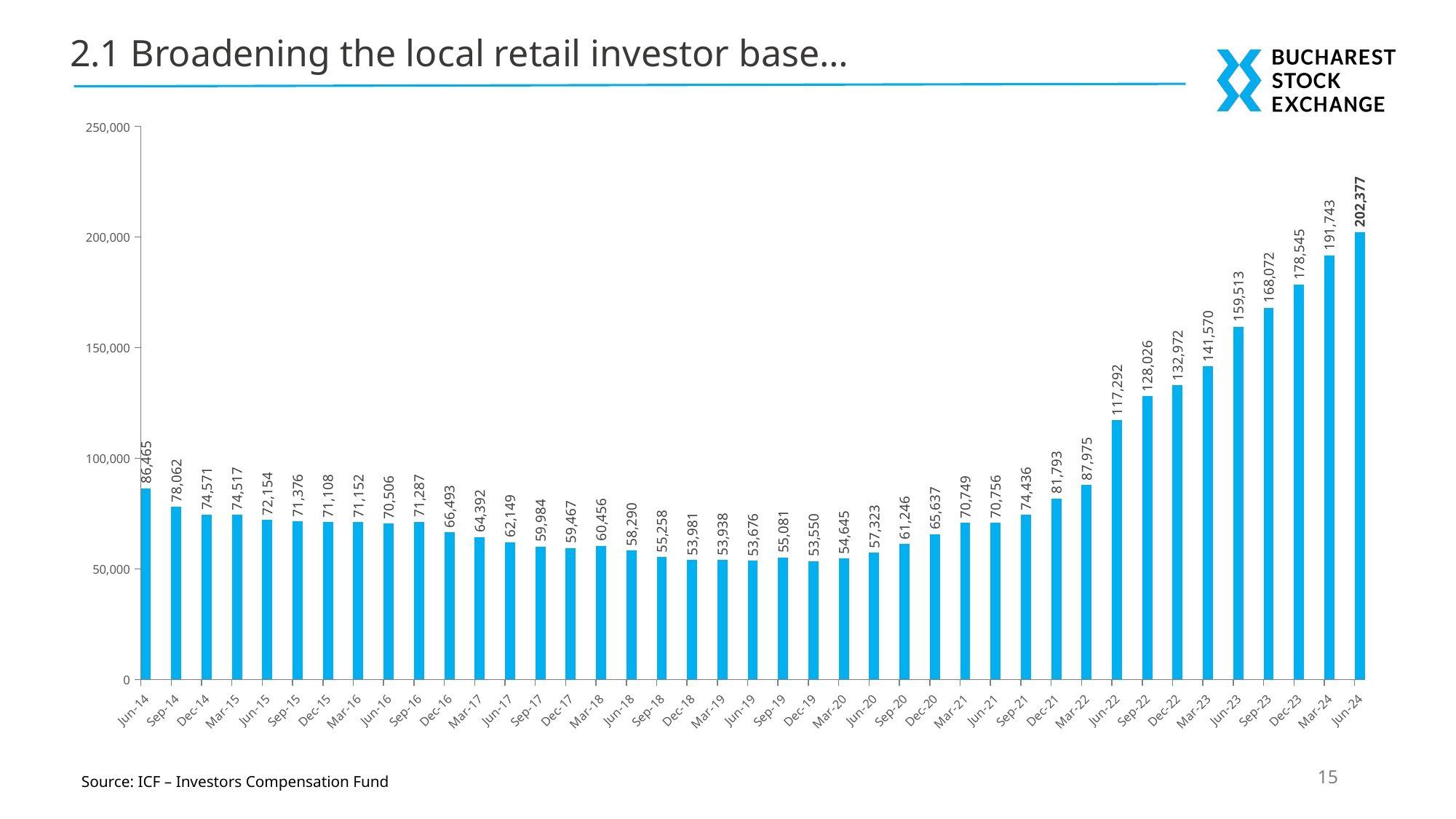
Which is larger, the value for Jun-14 or the value for Mar-22? Mar-22 What is the value for Sep-22? 128,026 What is the difference between the values for Jun-22 and Mar-22? 29,317 What is the difference between the values for Jun-24 and Mar-24? 10,634 Which period has the highest value? Jun-24 What is the value for Jun-14? 86,465 How many bars are plotted in the chart? 41 What is the value for Dec-21? 81,793 What is the value for Jun-24? 202,377 What is the source cited below the chart? ICF – Investors Compensation Fund Which period has the lowest value? Dec-19 What type of chart is shown on the slide? Bar chart